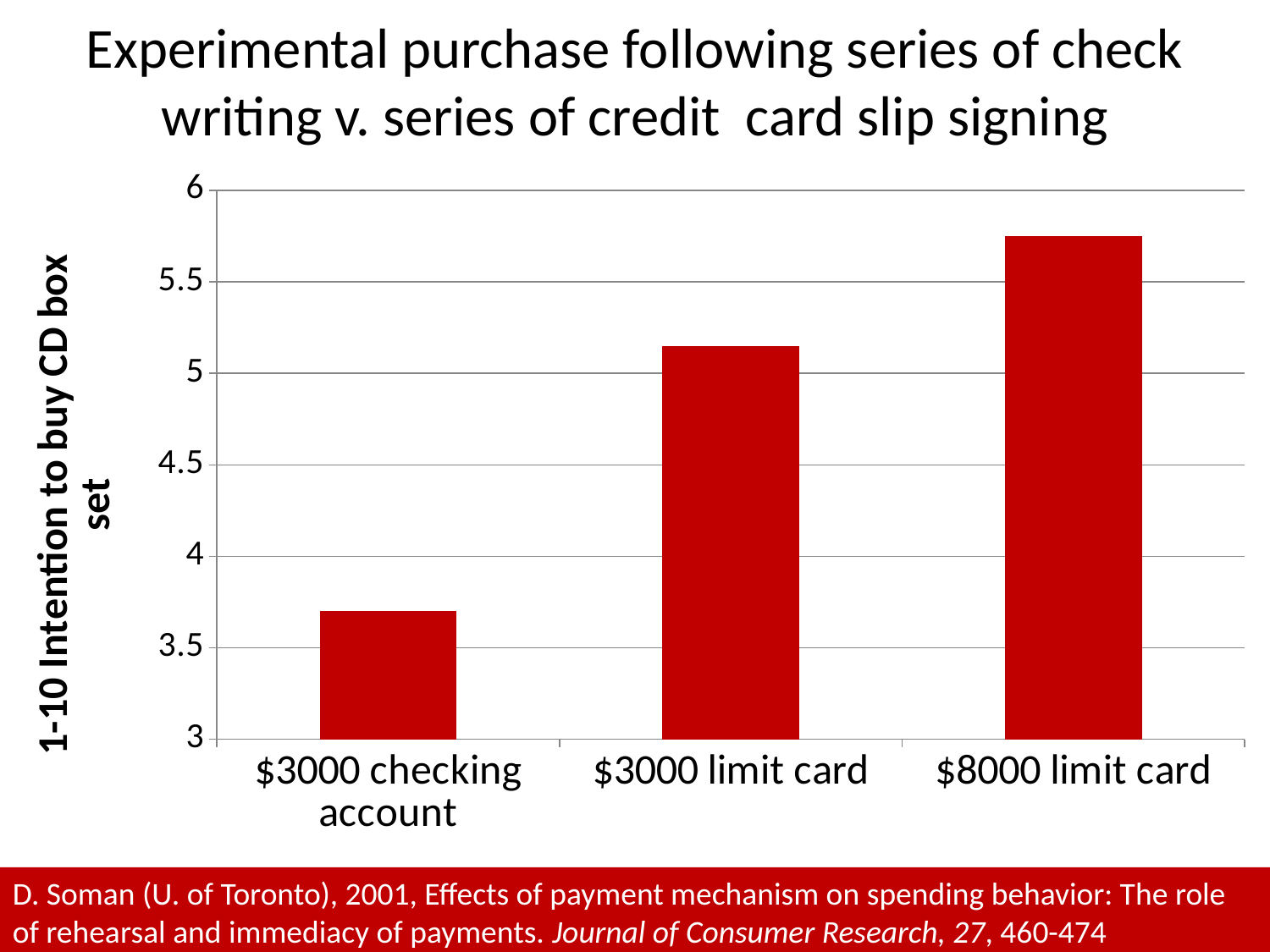
Is the value for $3000 limit card greater or less than 5.5? less Do the values rise or fall moving from left to right along the x axis? rise Which category has the highest intention to buy the CD box set? $8000 limit card What kind of chart is shown on the slide? bar chart How many categories are plotted on the x axis? 3 Is the value for $3000 limit card greater or less than 5? greater Is the value for $3000 checking account greater or less than 4? less Which category has the lowest intention to buy the CD box set? $3000 checking account What is the label of the vertical axis? 1-10 Intention to buy CD box set Which is larger, the value for $3000 checking account or the value for $3000 limit card? $3000 limit card What colour are the bars in the chart? red